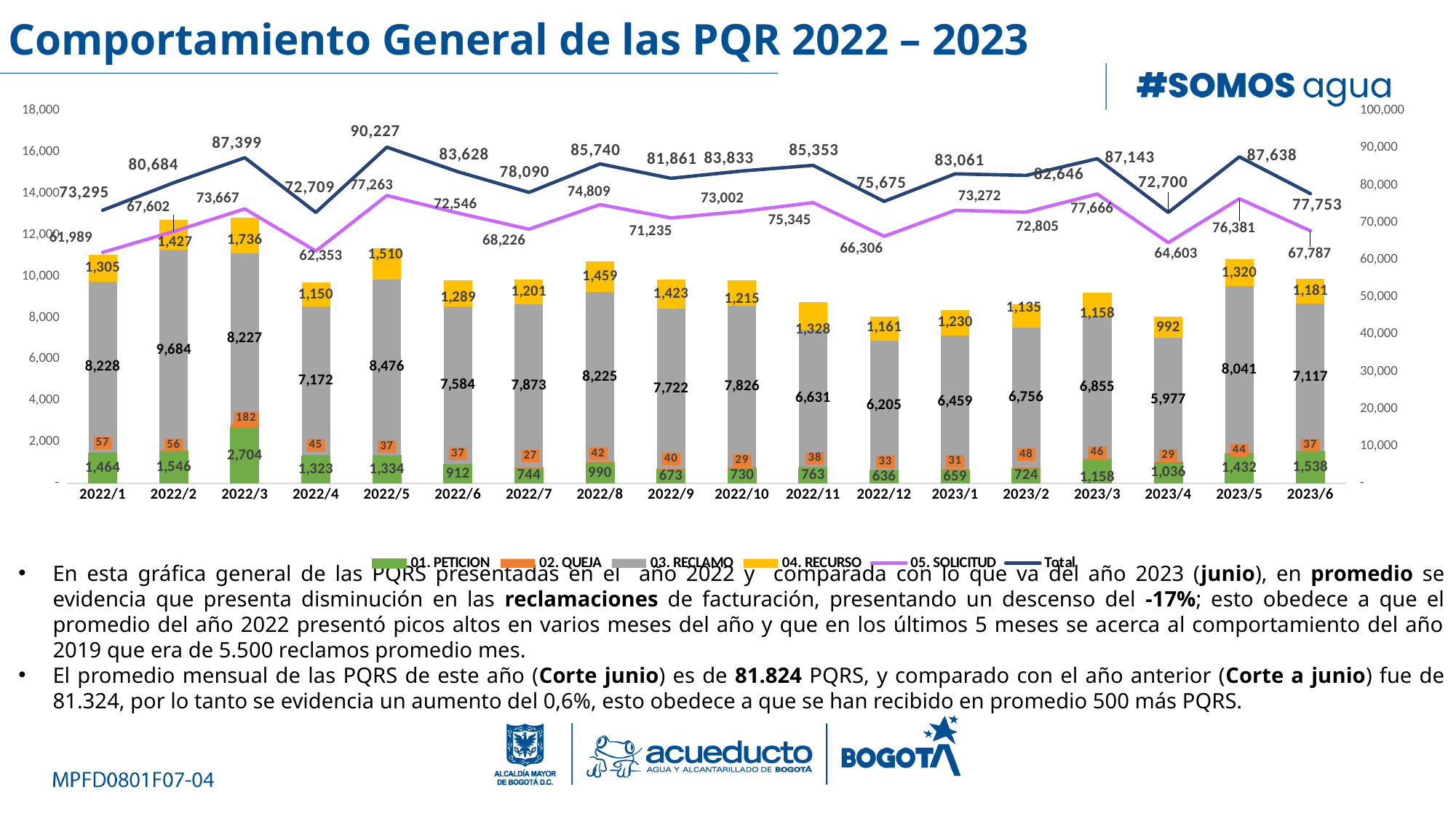
What is the Total value for 2022/5? 90,227 In which month is the 02. QUEJA value highest? 2022/3 Which has the larger 03. RECLAMO value, 2022/5 or 2023/5? 2022/5 How many months are shown on the x axis? 18 In which month is the 03. RECLAMO value lowest? 2023/4 What is the total of the stacked bar for 2022/1 (01. PETICION, 02. QUEJA, 03. RECLAMO and 04. RECURSO)? 11,054 What is the difference between the 03. RECLAMO values for 2022/2 and 2022/1? 1,456 What is the value of 01. PETICION for 2022/3? 2,704 What is the value of 05. SOLICITUD for 2023/6? 67,787 How many series does the legend list? 6 In which month does the Total line reach its highest value? 2022/5 What is the value of 03. RECLAMO for 2022/2? 9,684